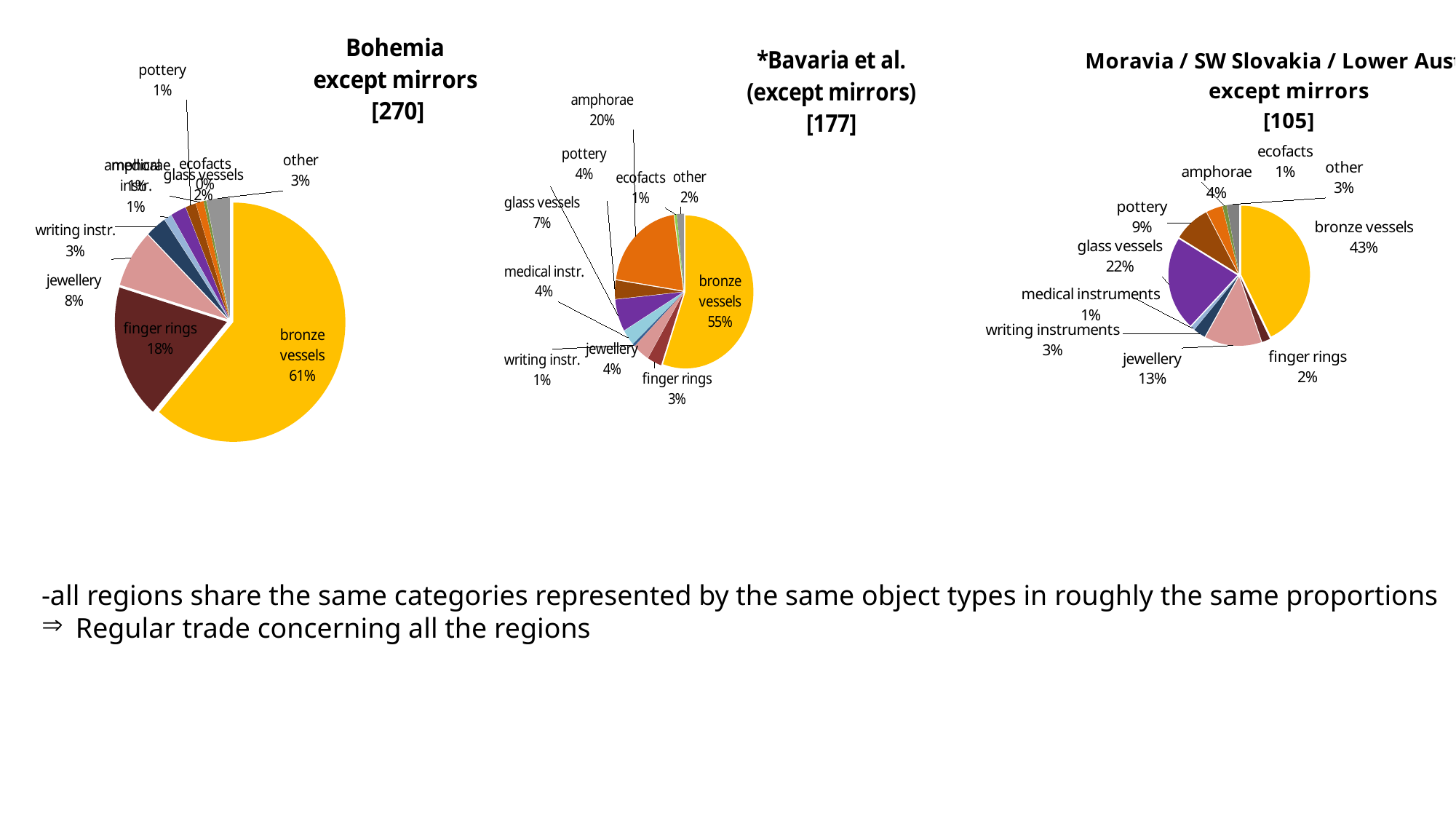
In the Bavaria et al. (except mirrors) pie chart, what share do amphorae have? 20% In the right-hand pie chart (Moravia / SW Slovakia / Lower Austria), what is the difference between the bronze vessels share and the glass vessels share? 21% What kind of chart is used for the Bavaria et al. (except mirrors) data? pie chart How many pie charts are shown on the slide? 3 In the Bohemia except mirrors pie chart, which category has the largest share? bronze vessels In the Bavaria et al. (except mirrors) pie chart, which is larger, amphorae or glass vessels? amphorae In the Bohemia except mirrors pie chart, what share do finger rings have? 18% In the right-hand pie chart (Moravia / SW Slovakia / Lower Austria), what share does jewellery have? 13% In the Bohemia except mirrors pie chart, what share do bronze vessels have? 61% In the Bohemia except mirrors pie chart, what is the difference between the bronze vessels share and the finger rings share? 43% In the Bavaria et al. (except mirrors) pie chart, what share do glass vessels have? 7% In the right-hand pie chart (Moravia / SW Slovakia / Lower Austria), what share do glass vessels have? 22%